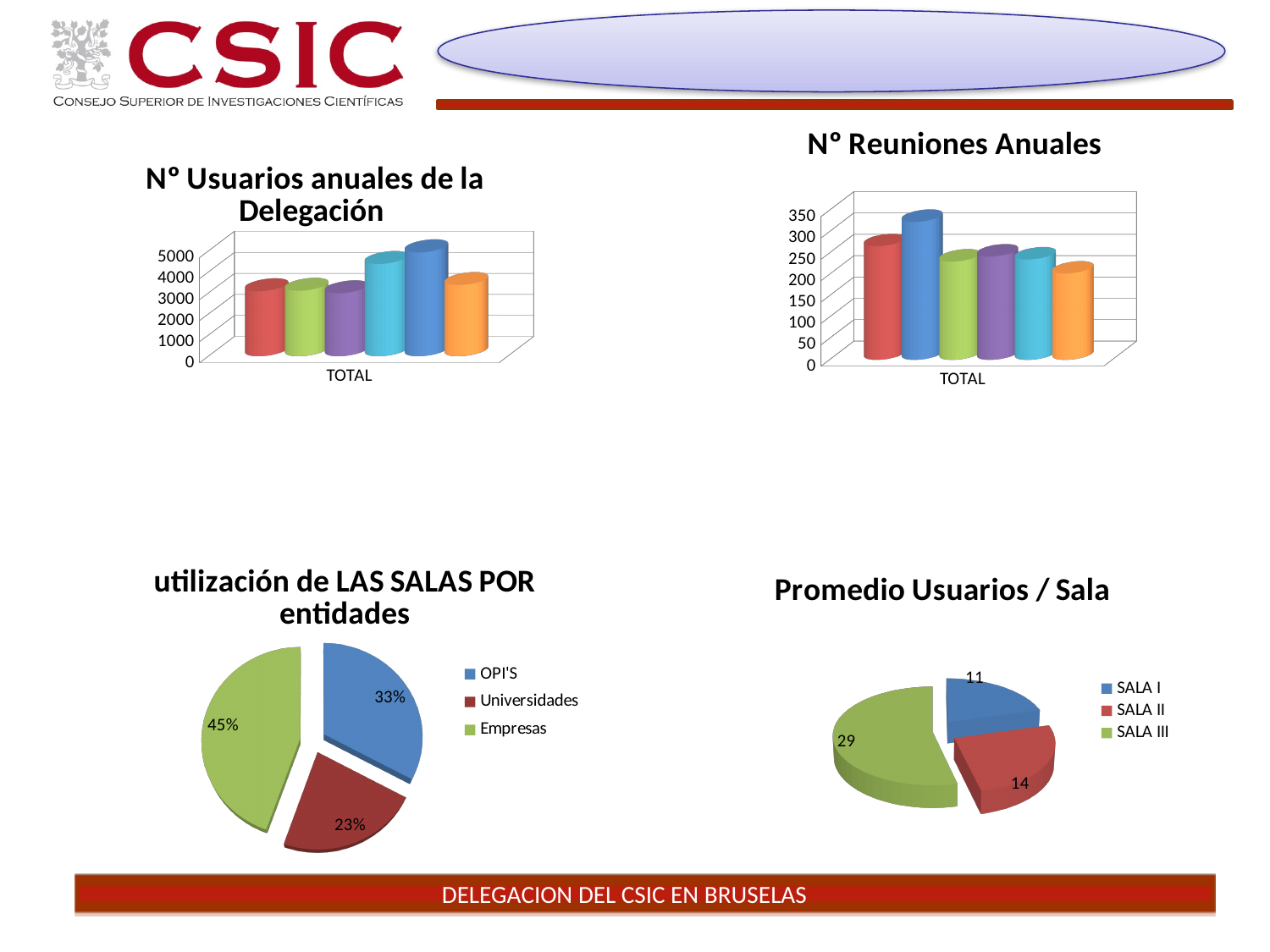
In the 'Promedio Usuarios / Sala' chart, what is the value for SALA II? 14 In the 'utilización de LAS SALAS POR entidades' chart, how many percentage points larger is OPI'S than Universidades? 10 In the 'Promedio Usuarios / Sala' chart, which sala has the highest value? SALA III What kind of chart is 'N° Reuniones Anuales'? Bar chart How many bars are shown in the 'N° Usuarios anuales de la Delegación' chart? 6 In the 'utilización de LAS SALAS POR entidades' chart, which entity has the largest share? Empresas How many entries does the legend of the 'Promedio Usuarios / Sala' chart list? 3 In the 'utilización de LAS SALAS POR entidades' chart, what share does Universidades have? 23% In the 'Promedio Usuarios / Sala' chart, what is the difference between SALA III and SALA I? 18 In the 'utilización de LAS SALAS POR entidades' chart, what share does Empresas have? 45% In the 'Promedio Usuarios / Sala' chart, which is larger, SALA I or SALA II? SALA II In the 'utilización de LAS SALAS POR entidades' chart, which entity has the smallest share? Universidades